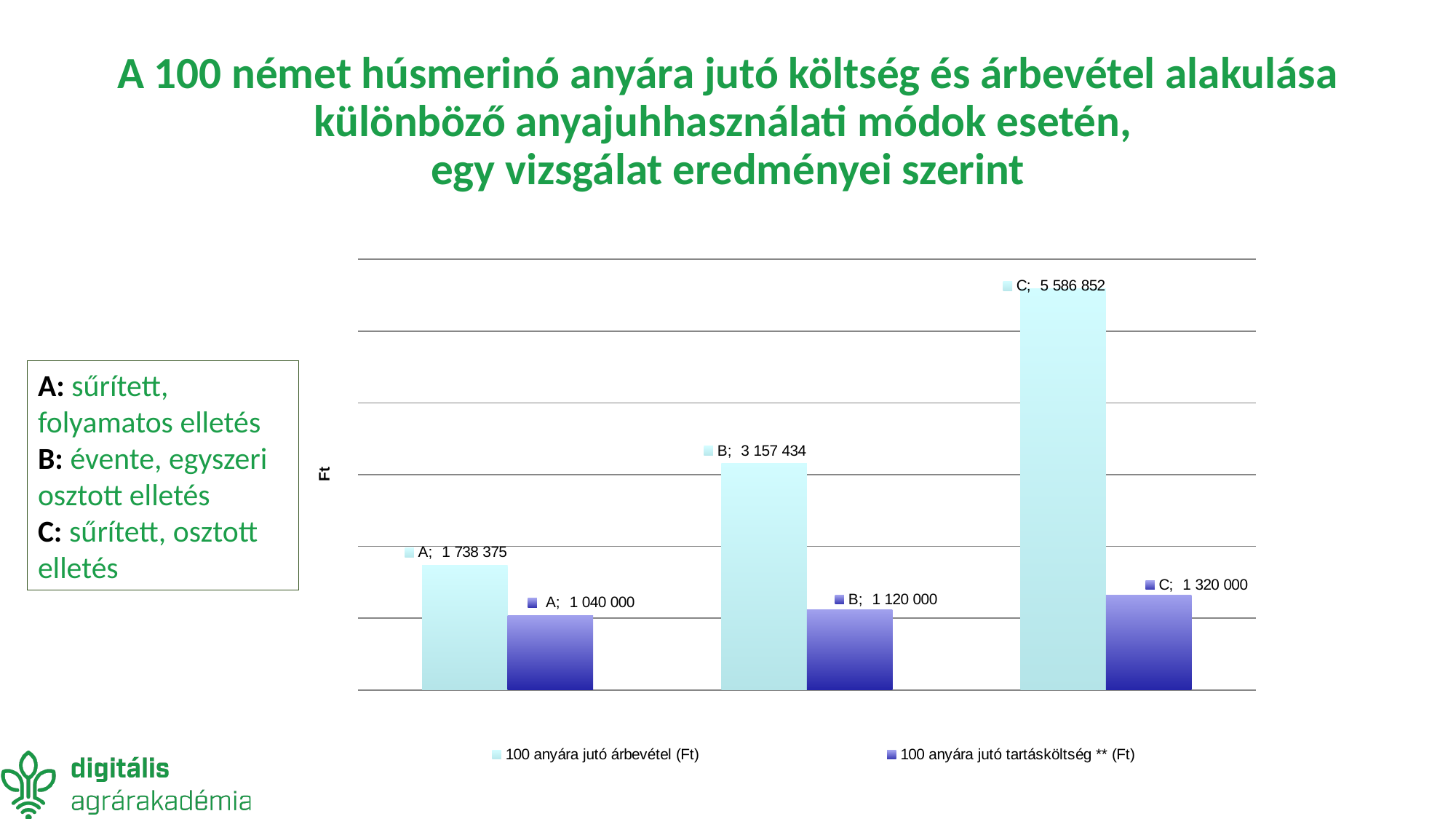
Which category has the lowest '100 anyára jutó tartásköltség ** (Ft)'? A What is the value of '100 anyára jutó árbevétel (Ft)' for category B? 3 157 434 What is the difference between '100 anyára jutó árbevétel (Ft)' and '100 anyára jutó tartásköltség ** (Ft)' for category C? 4 266 852 How many series does the legend list? 2 What is the value of '100 anyára jutó árbevétel (Ft)' for category C? 5 586 852 What is the value of '100 anyára jutó tartásköltség ** (Ft)' for category C? 1 320 000 What is the difference in '100 anyára jutó tartásköltség ** (Ft)' between category C and category A? 280 000 What kind of chart is shown on the slide? bar chart Which category has the highest '100 anyára jutó árbevétel (Ft)'? C Which is larger: '100 anyára jutó árbevétel (Ft)' for A or '100 anyára jutó tartásköltség ** (Ft)' for B? 100 anyára jutó árbevétel (Ft) for A What is the value of '100 anyára jutó tartásköltség ** (Ft)' for category A? 1 040 000 How many categories are shown on the x axis of the chart? 3